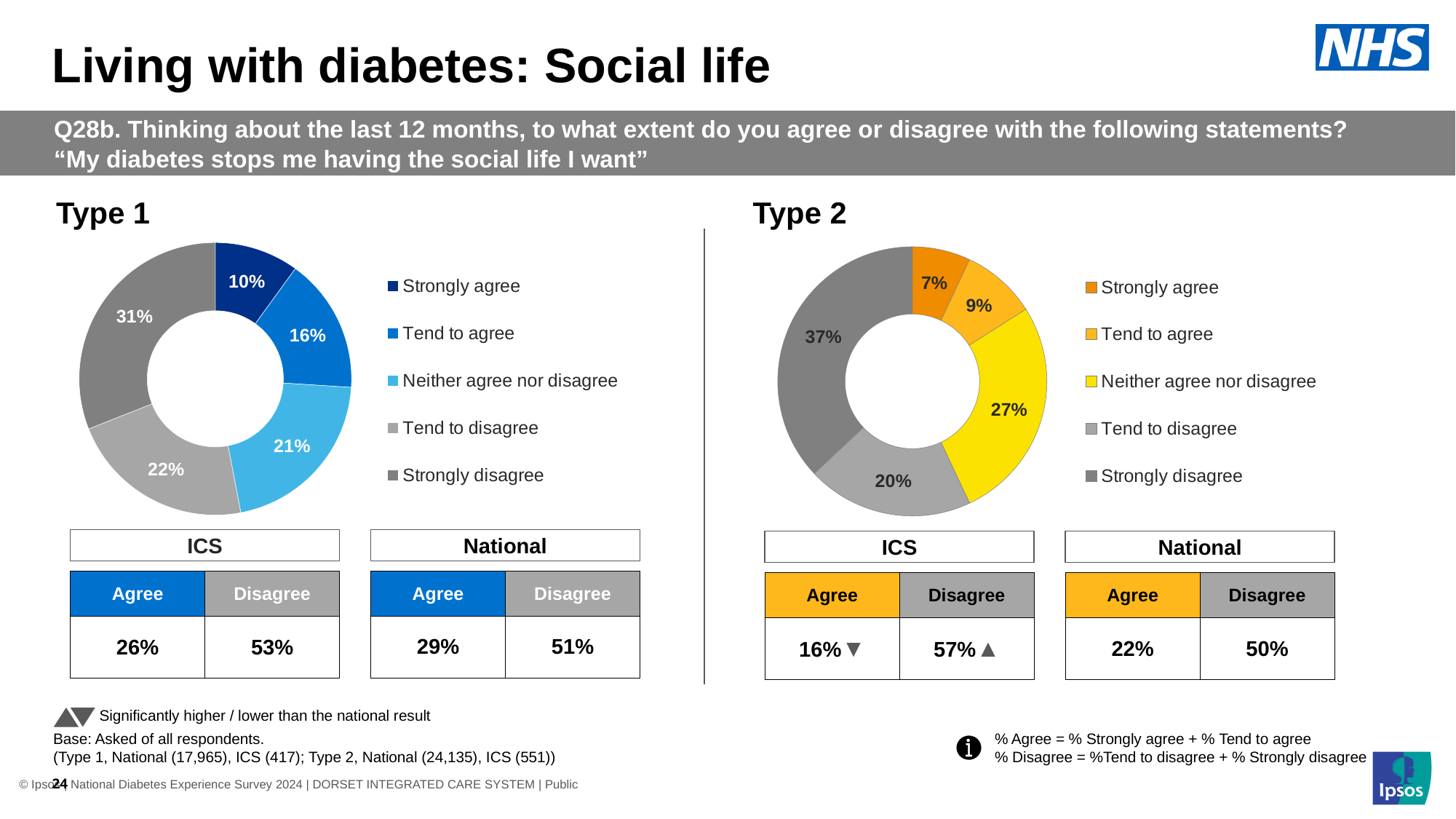
In the Type 1 chart, what is the difference between the 'Tend to disagree' and 'Tend to agree' shares? 6 percentage points In the Type 2 chart, what percentage of respondents said 'Neither agree nor disagree'? 27% In the Type 2 chart, which is larger: 'Tend to disagree' or 'Tend to agree'? Tend to disagree In the Type 1 chart, what is the combined share of 'Strongly agree' and 'Tend to agree'? 26% In the Type 2 chart, which response category has the smallest share? Strongly agree In the Type 2 chart, what colour is the 'Neither agree nor disagree' segment? Yellow How many response categories does the Type 1 chart show? 5 In the Type 1 chart, which response category has the largest share? Strongly disagree What kind of chart is used for the Type 2 results? Doughnut (pie) chart In the Type 1 chart, what is the 'Strongly disagree' share? 31% In the Type 2 chart, what is the combined share of 'Tend to disagree' and 'Strongly disagree'? 57% In the Type 1 chart, what percentage of respondents said 'Strongly agree'? 10%